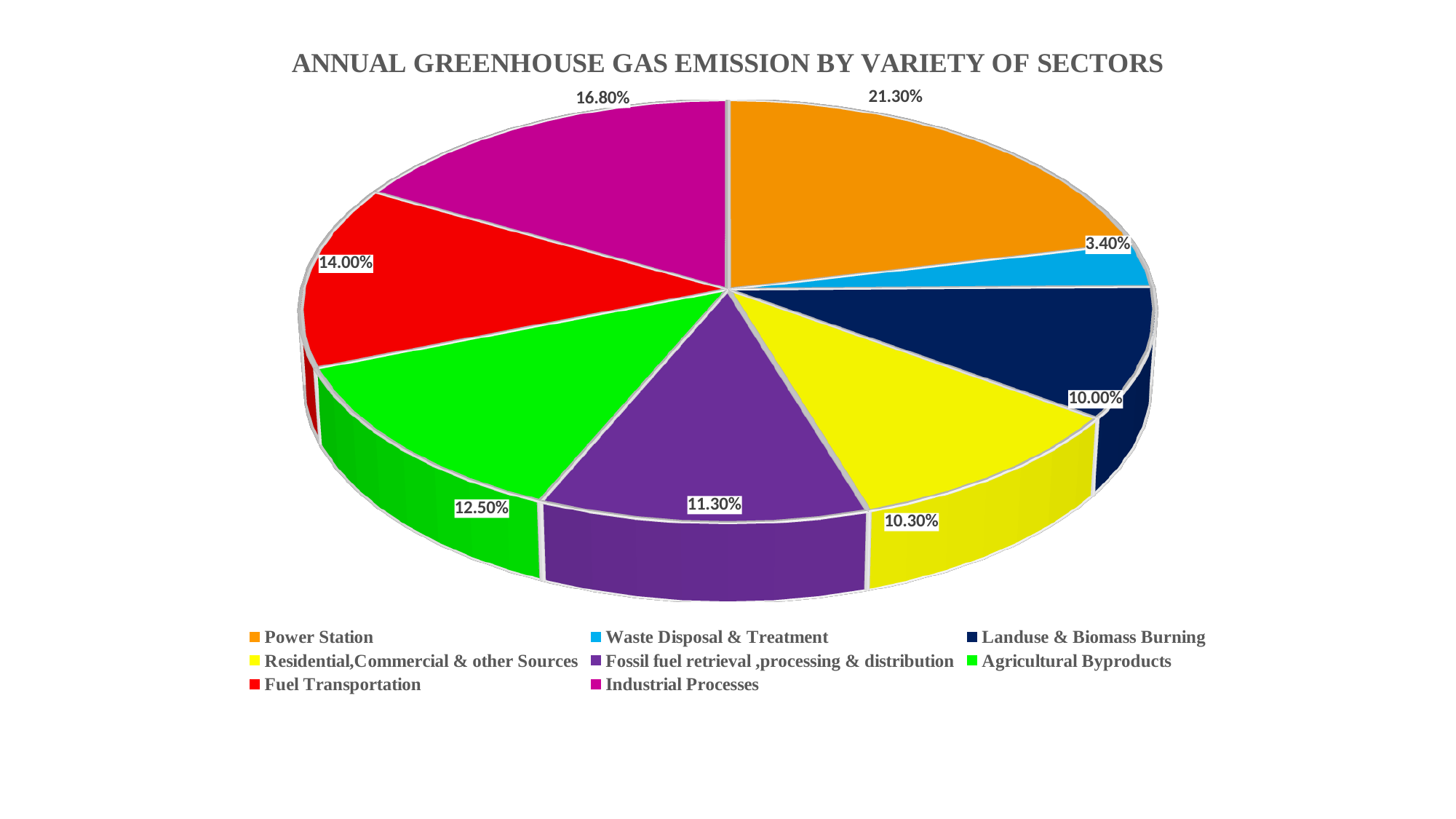
Which sector has the largest share of emissions? Power Station Which is larger, Fuel Transportation or Fossil fuel retrieval ,processing & distribution? Fuel Transportation How many sectors are shown in the pie chart? 8 Which sector has the smallest share of emissions? Waste Disposal & Treatment What is the value for Agricultural Byproducts? 12.50% What is the difference between the Power Station and Industrial Processes shares? 4.50% What is the value for Industrial Processes? 16.80% What kind of chart is shown on the slide? Pie chart What is the title of the chart? ANNUAL GREENHOUSE GAS EMISSION BY VARIETY OF SECTORS What percentage of emissions comes from Power Station? 21.30% What is the value for Waste Disposal & Treatment? 3.40% What colour is the slice for Landuse & Biomass Burning? Dark navy blue